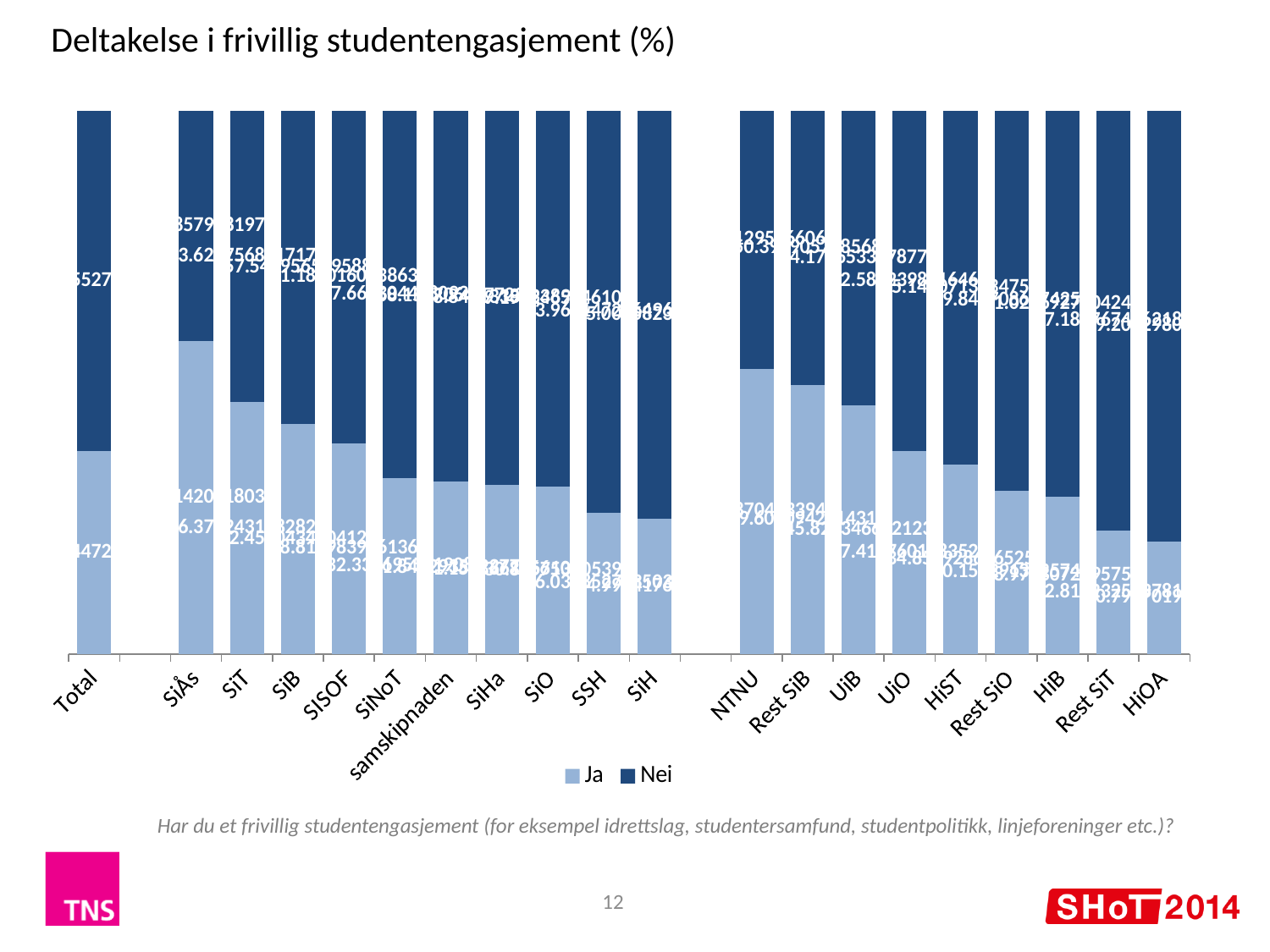
What kind of chart is shown on the slide? Stacked bar chart How many categories are shown along the x axis? 20 Which category has the largest Ja share? SiÅs Which has a larger Nei share, SiH or SiÅs? SiH What is the title of the chart? Deltakelse i frivillig studentengasjement (%) Which has a larger Nei share, HiOA or NTNU? HiOA Which has a larger Ja share, Total or SiÅs? SiÅs What are the two series named in the legend? Ja and Nei How many series does the legend list? 2